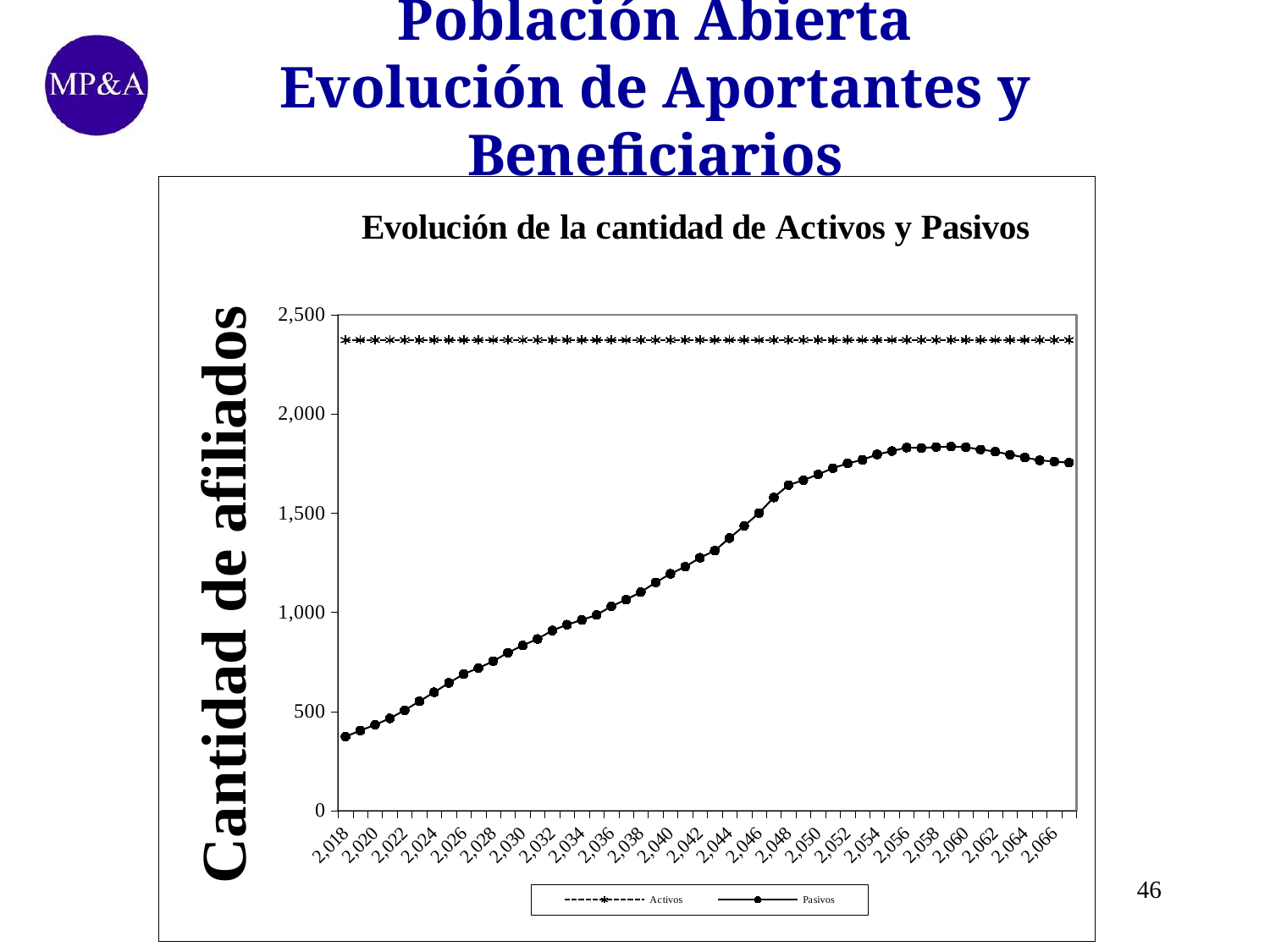
Is the value for Pasivos in 2,018 greater or less than 500? less What are the two series named in the legend? Activos and Pasivos Is the value for Pasivos in 2,030 greater or less than 1,000? less How many series does the legend list? 2 Which series has the larger value in 2,050, Activos or Pasivos? Activos Is the value for Activos in 2,040 greater or less than 2,000? greater What is the first year label shown on the x axis? 2,018 Which series stays higher across the whole period shown? Activos Do the values for Pasivos rise or fall between 2,018 and 2,056? rise What kind of chart is shown on the slide? line chart What is the title of the chart? Evolución de la cantidad de Activos y Pasivos